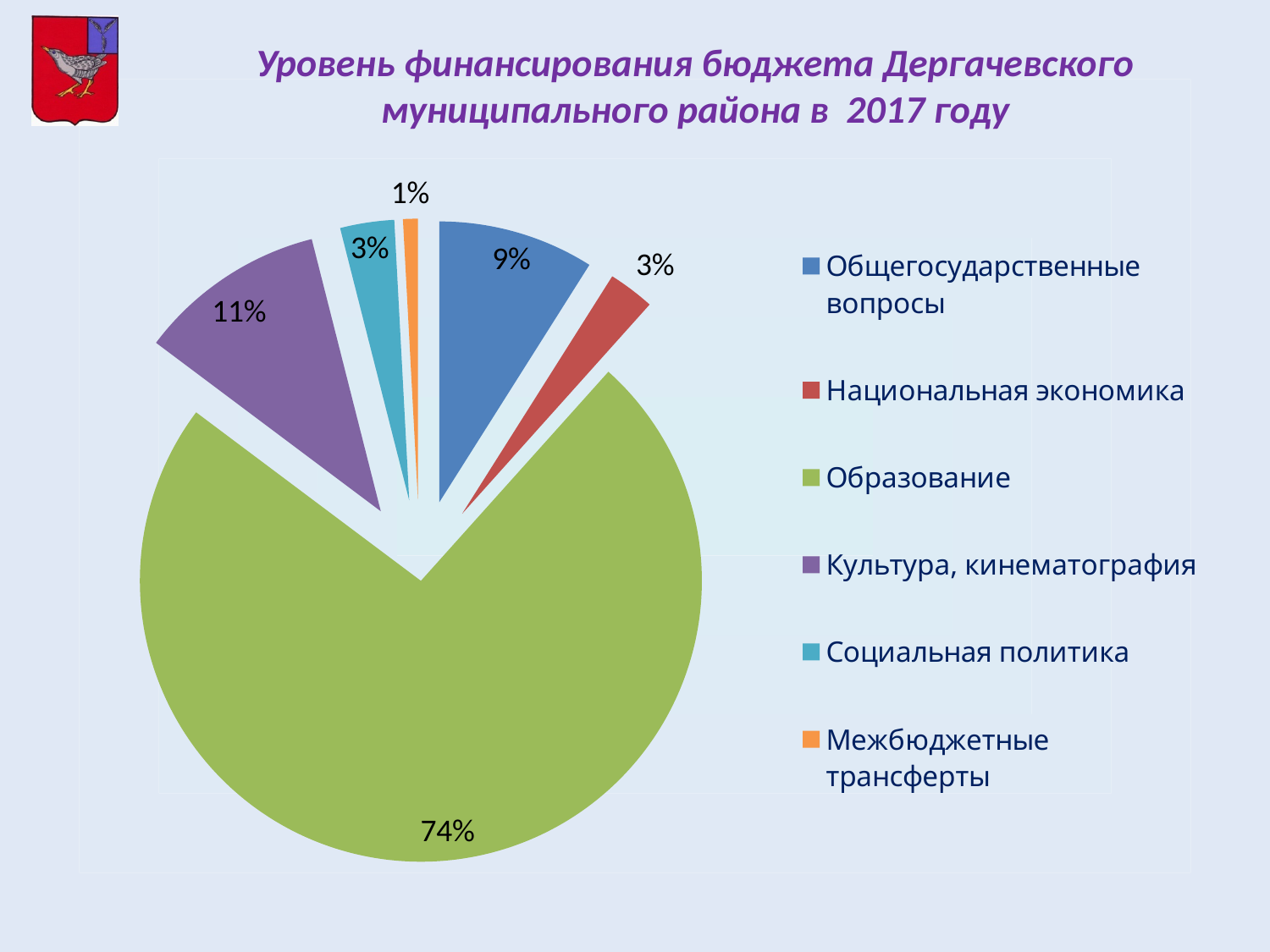
What share of the pie does Образование account for? 74% What is the difference in percentage points between Образование and Культура, кинематография? 63 What colour is the slice for Национальная экономика? Red Which category has the largest share of the pie? Образование What is the value shown for Межбюджетные трансферты? 1% What is the value shown for Социальная политика? 3% How many categories does the pie chart show? 6 What is the value shown for Культура, кинематография? 11% What type of chart is shown on the slide? Pie chart What is the value shown for Общегосударственные вопросы? 9% Which category has the smallest share of the pie? Межбюджетные трансферты Which is larger, the share for Общегосударственные вопросы or the share for Национальная экономика? Общегосударственные вопросы